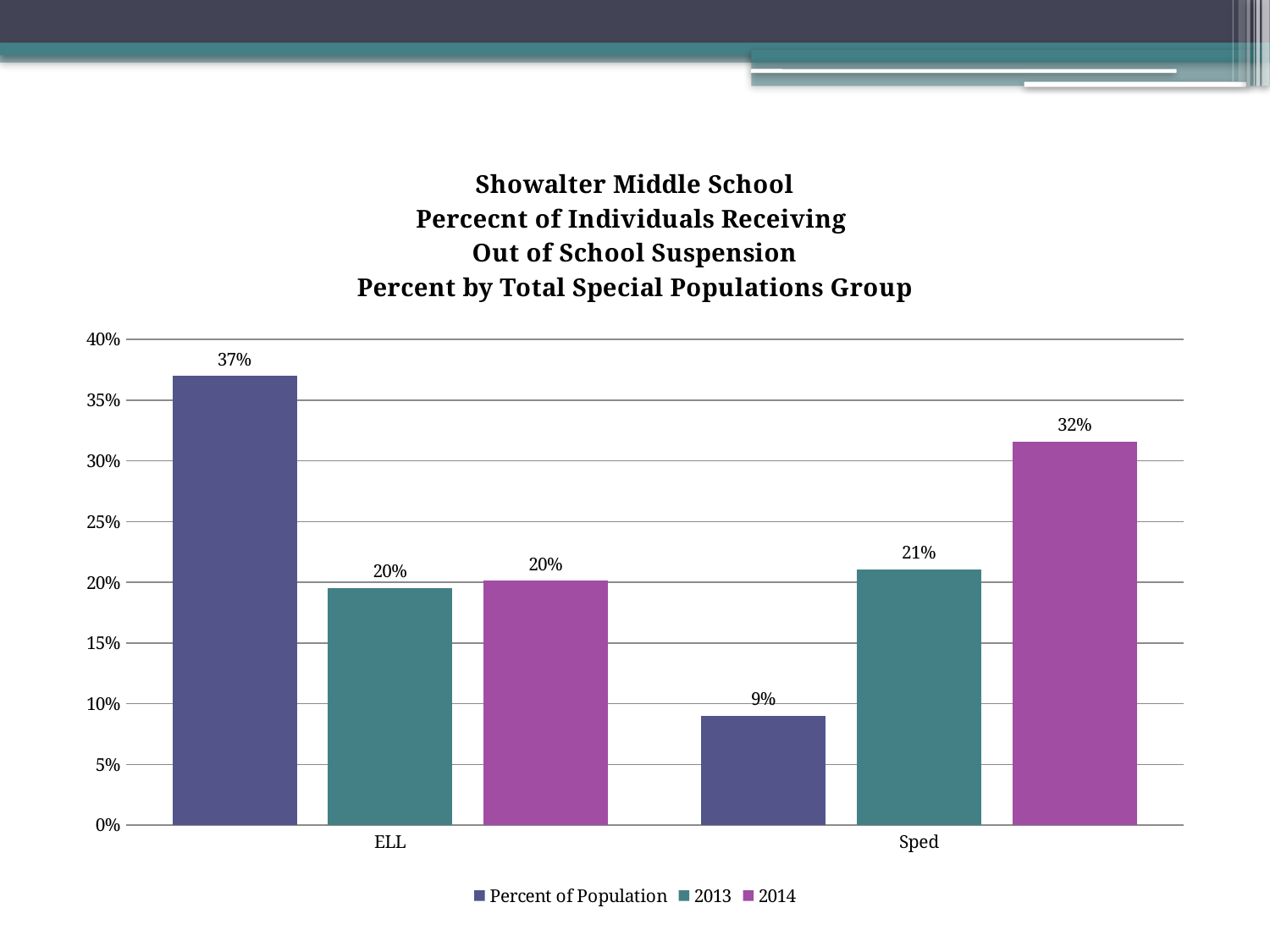
What kind of chart is shown on the slide? bar chart Which category has the highest Percent of Population value? ELL Which is larger, the Percent of Population value for ELL or the 2014 value for Sped? Percent of Population value for ELL How many categories are shown on the x axis? 2 What is the 2013 value for Sped? 21% Which category has the lowest 2014 value? ELL Is the 2013 value for Sped greater or less than 25%? less What is the Percent of Population value for ELL? 37% What is the 2014 value for Sped? 32% What is the Percent of Population value for Sped? 9% What is the difference between the 2014 value for Sped and the 2014 value for ELL? 12% How many series does the legend list? 3